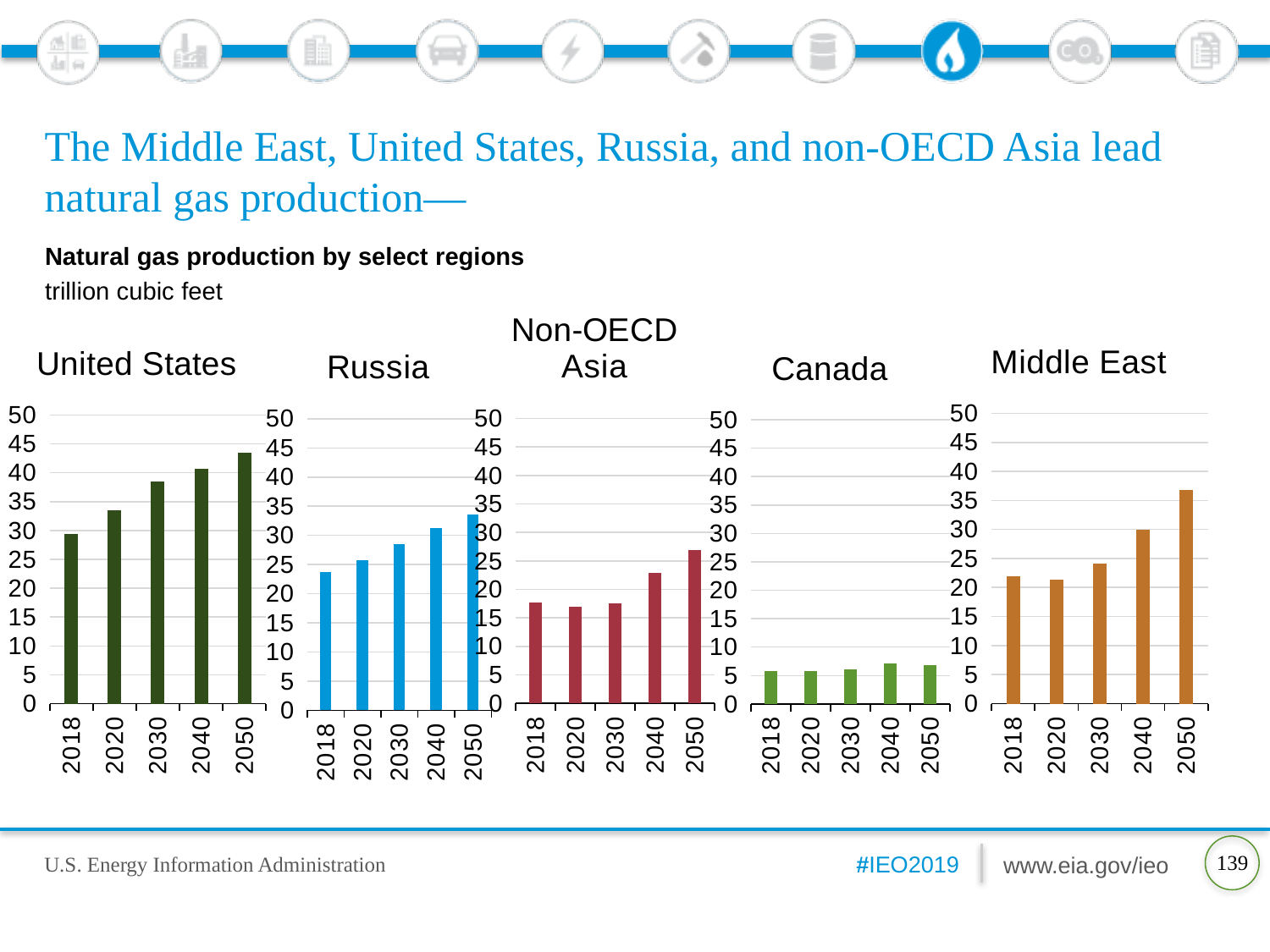
In the Canada chart, is the value for 2018 greater or less than 10? less How many years are shown on the x axis of the Russia chart? 5 In the Russia chart, which year has the highest value? 2050 In the Russia chart, is the value for 2018 greater or less than 25? less In the Non-OECD Asia chart, which year has the highest value? 2050 Do the values in the United States chart rise or fall from 2018 to 2050? rise In the United States chart, is the value for 2050 greater or less than 40? greater What kind of chart is used for the United States panel? bar chart In the Middle East chart, which year has the highest value? 2050